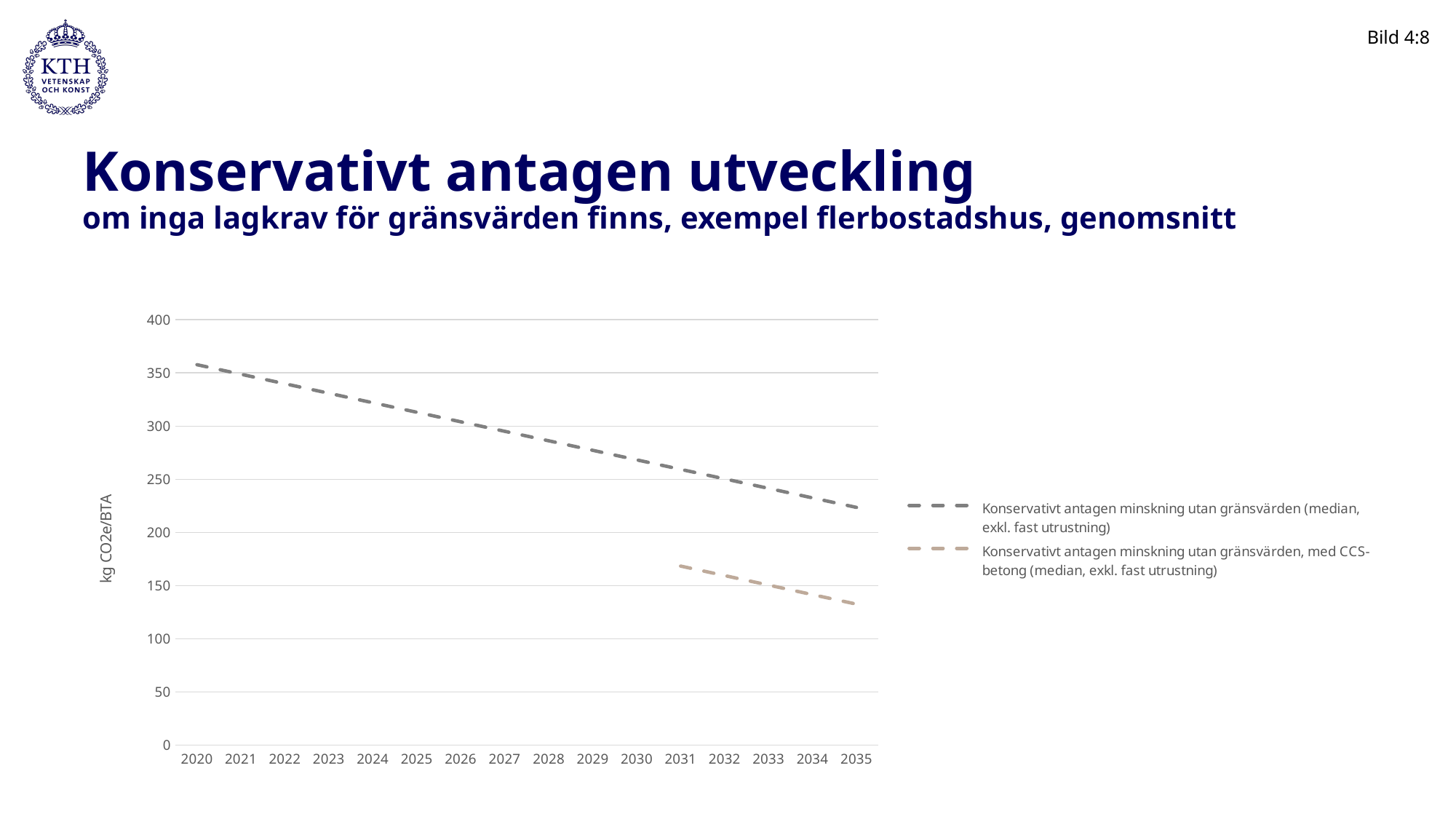
How many series does the legend list? 2 How many years are labelled on the x axis? 16 In which year does the series 'Konservativt antagen minskning utan gränsvärden, med CCS-betong (median, exkl. fast utrustning)' start? 2031 Does the series 'Konservativt antagen minskning utan gränsvärden, med CCS-betong (median, exkl. fast utrustning)' rise or fall from 2031 to 2035? fall What kind of chart is shown on the slide? line chart Is the 2031 value for 'Konservativt antagen minskning utan gränsvärden, med CCS-betong (median, exkl. fast utrustning)' greater or less than 200? less Is the 2020 value for 'Konservativt antagen minskning utan gränsvärden (median, exkl. fast utrustning)' greater or less than 350? greater Is the 2035 value for 'Konservativt antagen minskning utan gränsvärden, med CCS-betong (median, exkl. fast utrustning)' greater or less than 150? less What is the label on the y axis? kg CO2e/BTA Does the series 'Konservativt antagen minskning utan gränsvärden (median, exkl. fast utrustning)' rise or fall from 2020 to 2035? fall In 2035, which series has the higher value: the one without CCS-betong or the one with CCS-betong? the one without CCS-betong